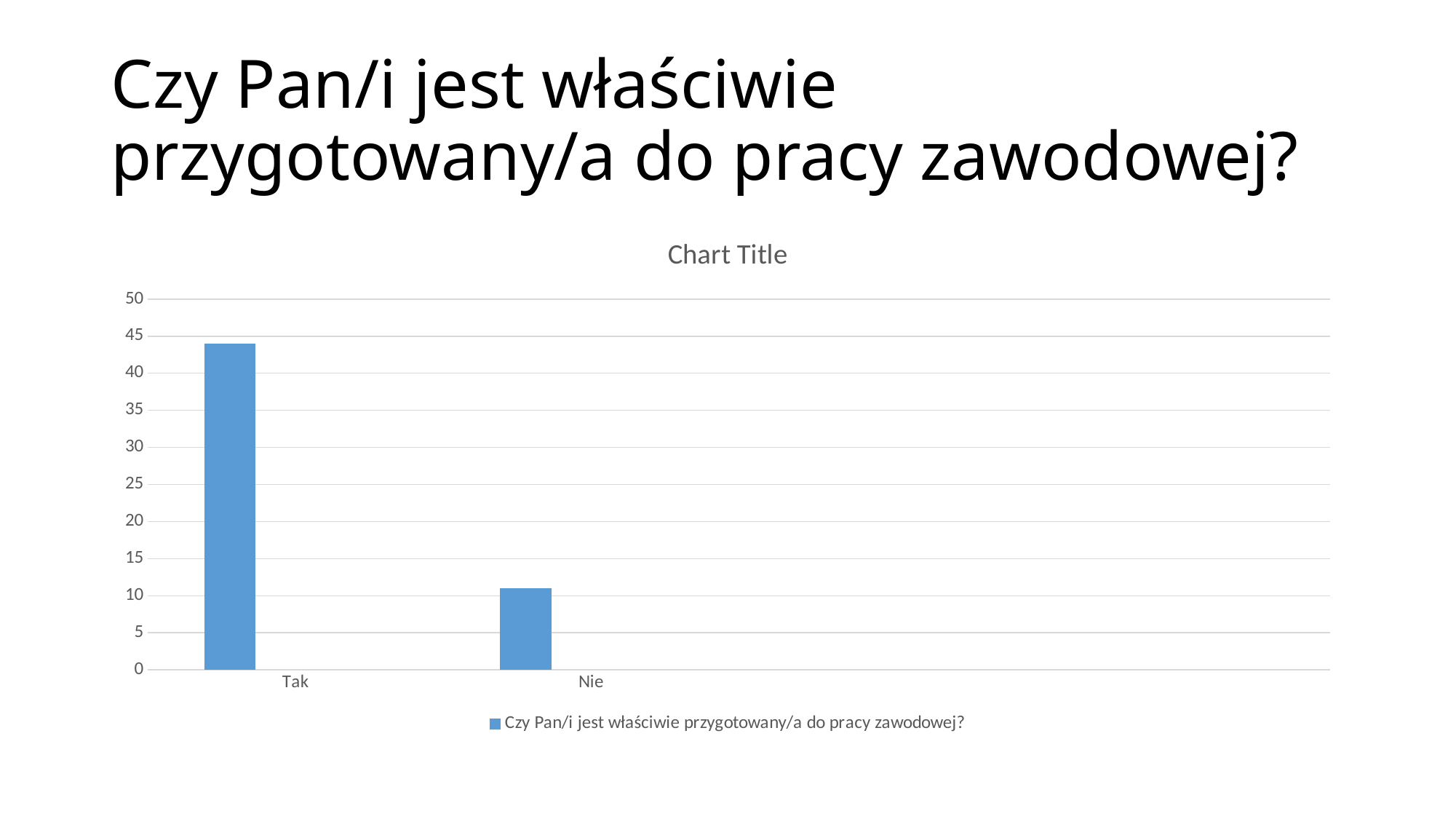
Is the value for Tak greater or less than 40? greater Which category has the highest value in the chart? Tak Is the value for Nie greater or less than 15? less What kind of chart is shown on the slide? bar chart Which is larger, the value for Tak or the value for Nie? Tak How many series does the chart legend list? 1 Which category has the lowest value in the chart? Nie What is the title shown above the chart? Chart Title How many categories are shown on the x axis of the chart? 2 What series name is shown in the chart legend? Czy Pan/i jest właściwie przygotowany/a do pracy zawodowej?